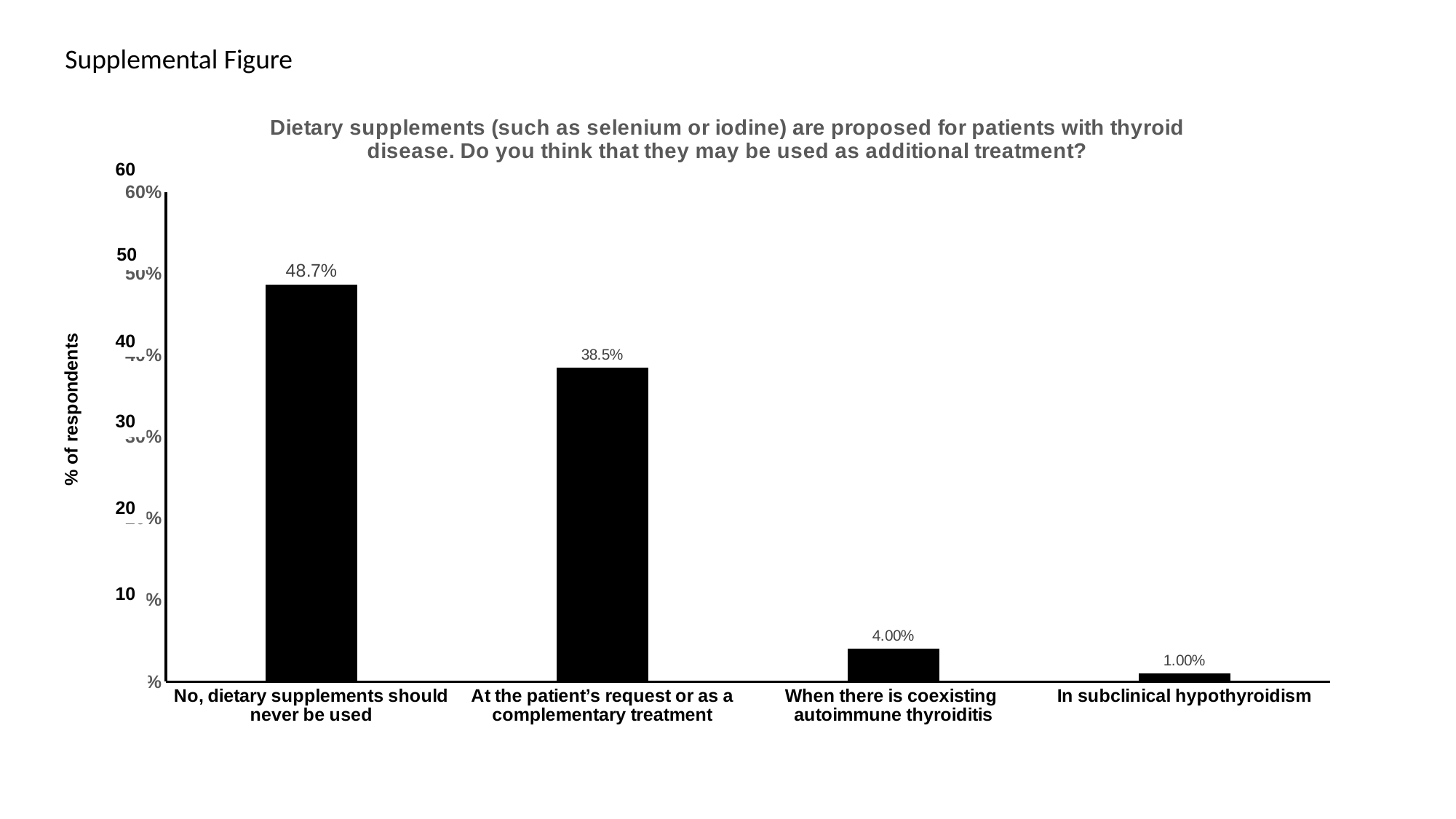
Which response category has the highest percentage of respondents? No, dietary supplements should never be used What is the difference in percentage points between "No, dietary supplements should never be used" and "At the patient's request or as a complementary treatment"? 10.2 Which response category has the lowest percentage of respondents? In subclinical hypothyroidism Which is larger: the value for "When there is coexisting autoimmune thyroiditis" or the value for "In subclinical hypothyroidism"? When there is coexisting autoimmune thyroiditis What percentage of respondents answered "When there is coexisting autoimmune thyroiditis"? 4.00% What percentage of respondents answered "At the patient's request or as a complementary treatment"? 38.5% Is the value for "At the patient's request or as a complementary treatment" greater or less than 40%? less What percentage of respondents answered "No, dietary supplements should never be used"? 48.7% What is the label of the vertical axis? % of respondents What kind of chart is shown on the slide? Bar chart How many response categories are shown on the chart? 4 What percentage of respondents answered "In subclinical hypothyroidism"? 1.00%